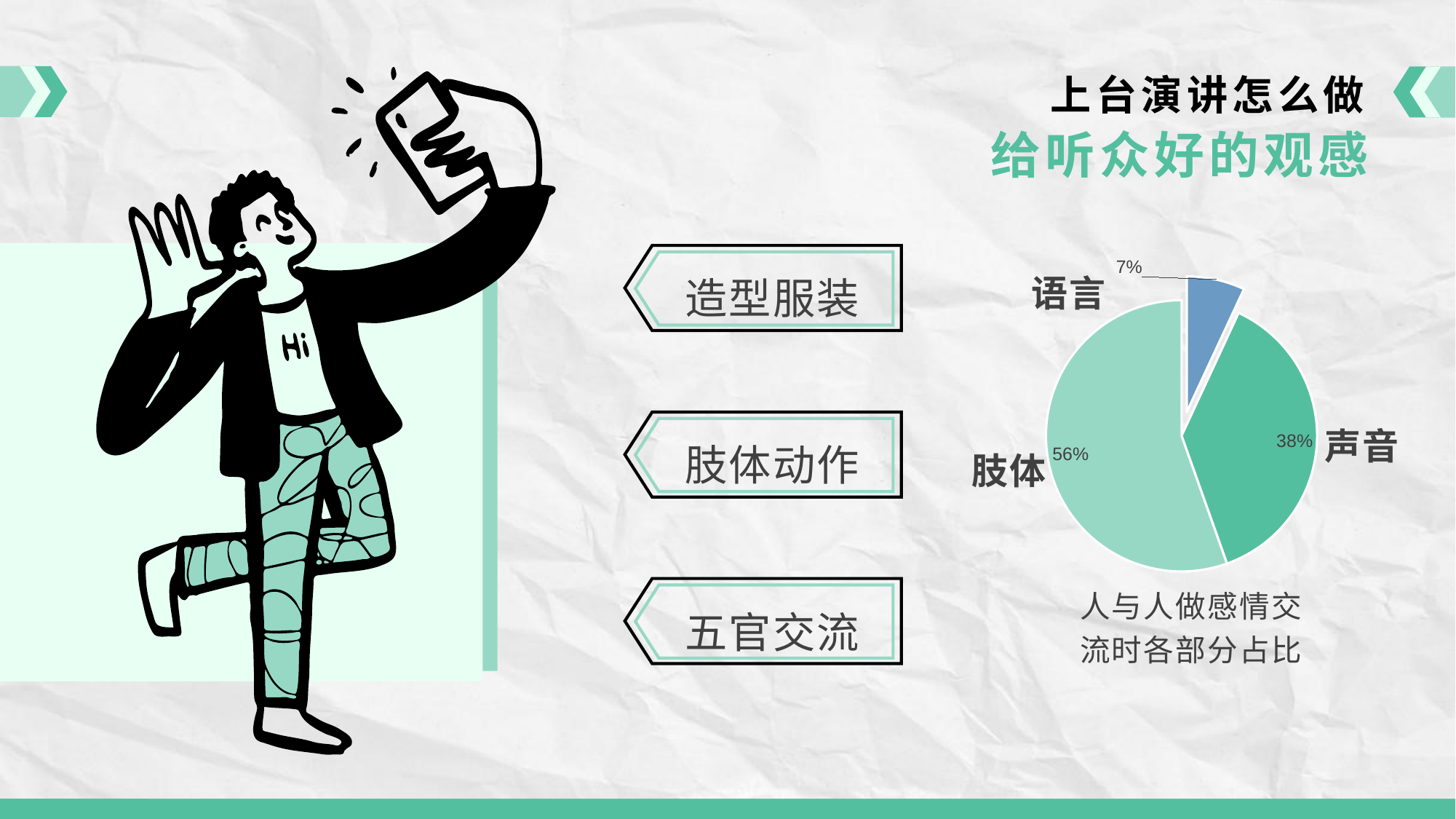
Which slice of the pie chart is the largest? 肢体 Which is larger, the share for 声音 or the share for 语言? 声音 What share of the pie does 语言 account for? 7% What is the difference in percentage points between 声音 and 语言? 31 How many slices does the pie chart have? 3 What caption is written below the pie chart? 人与人做感情交流时各部分占比 What kind of chart is shown on the slide? pie chart What share of the pie does 声音 account for? 38% What colour is the 语言 slice of the pie chart? blue What share of the pie does 肢体 account for? 56% What is the difference in percentage points between 肢体 and 声音? 18 Which slice of the pie chart is the smallest? 语言